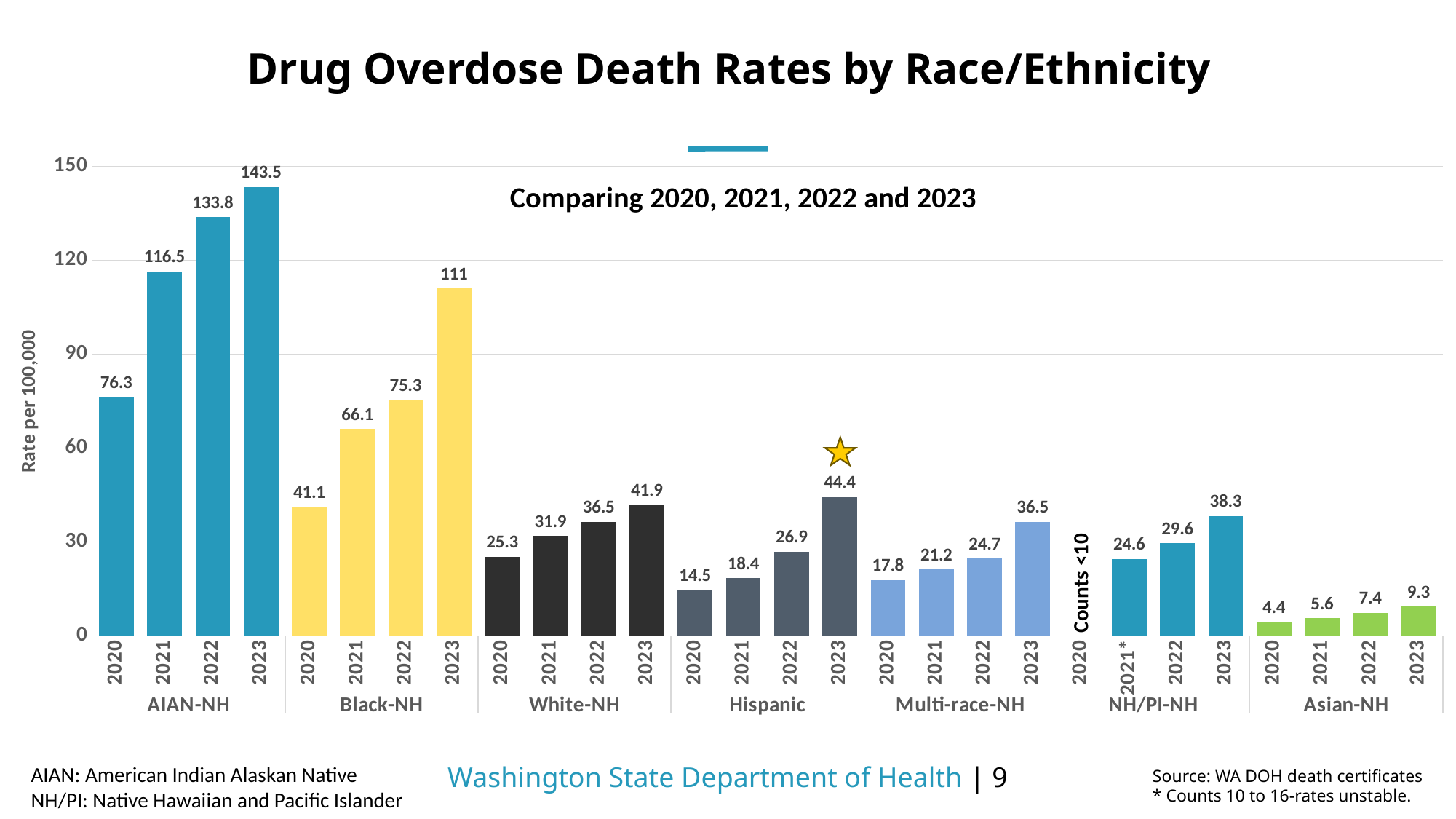
What is the difference between the AIAN-NH rates in 2023 and 2020? 67.2 What is the drug overdose death rate for Asian-NH in 2022? 7.4 What is the drug overdose death rate for Black-NH in 2023? 111 What is the drug overdose death rate for AIAN-NH in 2023? 143.5 What is shown in place of a bar for NH/PI-NH in 2020? Counts <10 Do the Asian-NH drug overdose death rates rise or fall from 2020 to 2023? Rise Which is larger, the White-NH rate in 2023 or the Hispanic rate in 2023? Hispanic rate in 2023 What kind of chart is shown on the slide? Bar chart Which race/ethnicity group has the lowest drug overdose death rate in 2020 among groups with a plotted bar? Asian-NH How many race/ethnicity groups are shown on the x axis? 7 What is the drug overdose death rate for Hispanic in 2020? 14.5 Which race/ethnicity group has the highest drug overdose death rate in 2023? AIAN-NH